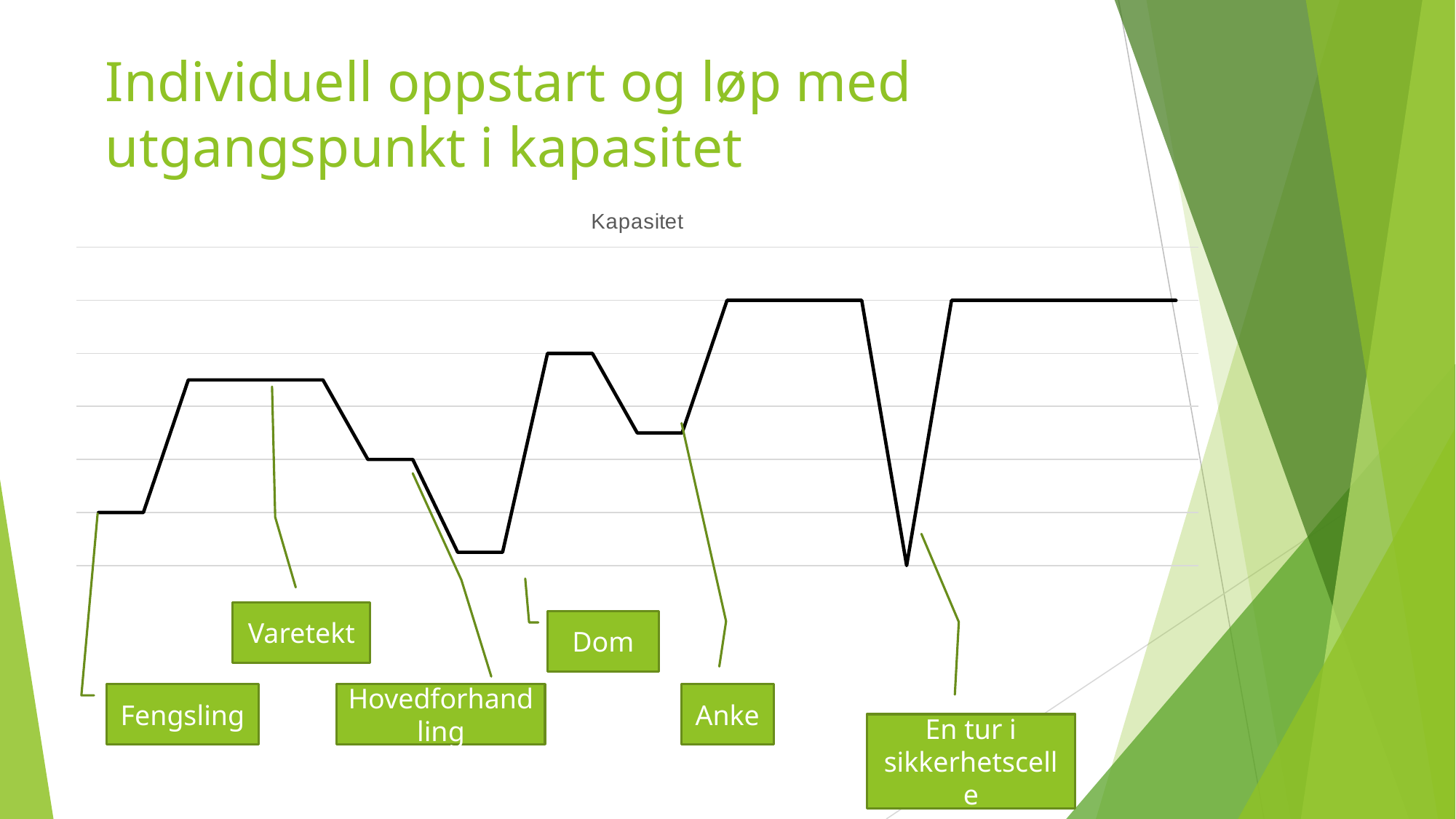
Is the line at the Varetekt plateau higher or lower than at the Fengsling start? higher Which stage annotation is placed furthest to the left on the chart? Fengsling Is the line higher or lower at its right end than at its left start? higher What is the title of the chart? Kapasitet How many green annotation boxes label stages along the line? 6 Is the line at the Dom peak higher or lower than at the Varetekt plateau? higher Does the line reach its highest plateau before or after the Anke annotation? after What kind of chart is shown on the slide? line chart